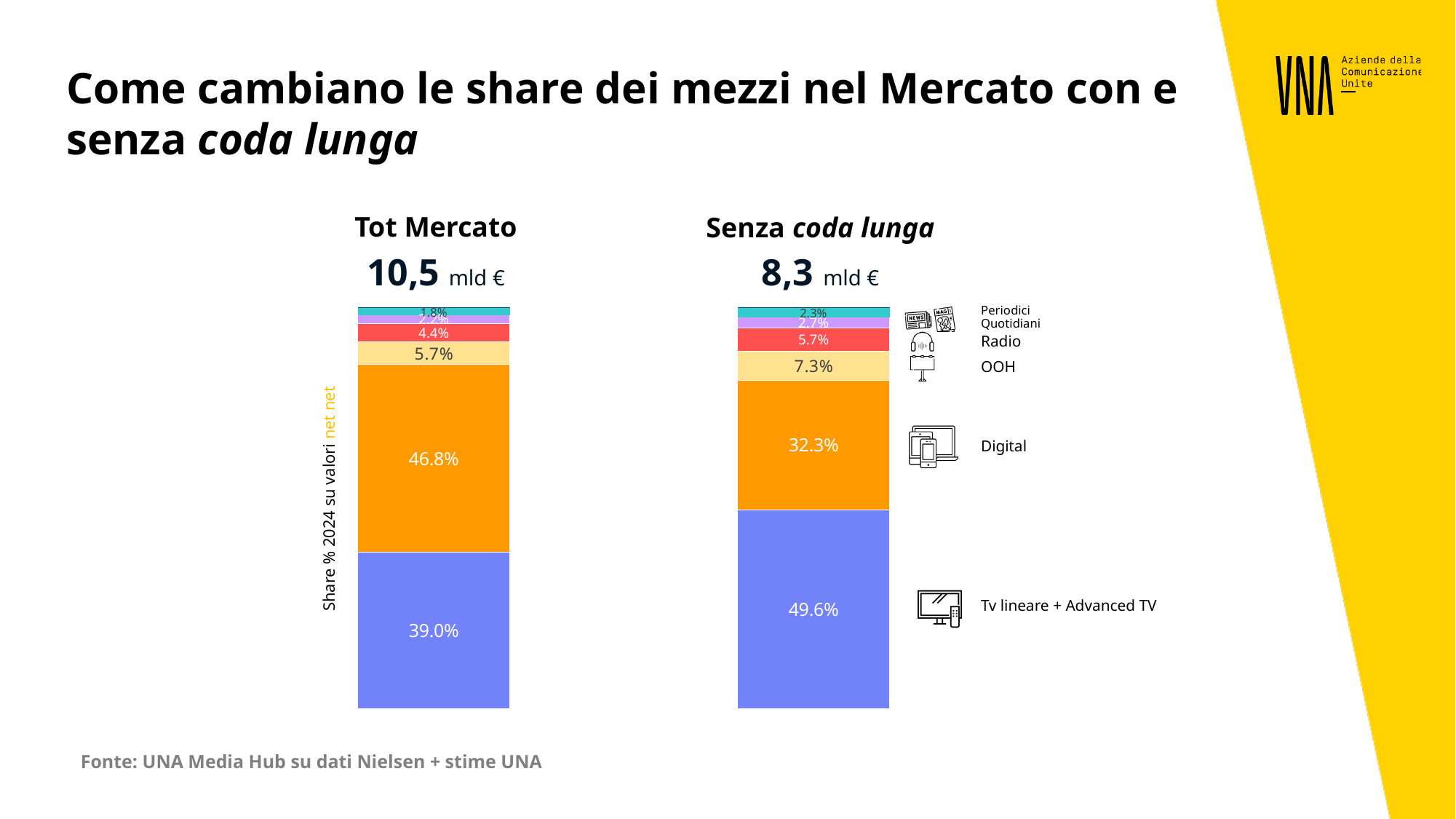
Which medium has the smallest share in the Tot Mercato bar? Periodici What is the share of Digital in the Tot Mercato bar? 46.8% What is the share of OOH in the Senza coda lunga bar? 7.3% What kind of chart is shown on the slide? Stacked bar chart Which medium has the largest share in the Tot Mercato bar? Digital Which medium has the largest share in the Senza coda lunga bar? Tv lineare + Advanced TV By how many percentage points does the Digital share in Tot Mercato exceed the Digital share in Senza coda lunga? 14.5 percentage points What total market value is shown above the Tot Mercato bar? 10,5 mld € What is the share of Radio in the Tot Mercato bar? 4.4% Is the share of Tv lineare + Advanced TV larger in the Tot Mercato bar or in the Senza coda lunga bar? Senza coda lunga How many media categories are shown in each stacked bar? 6 What is the share of Tv lineare + Advanced TV in the Senza coda lunga bar? 49.6%